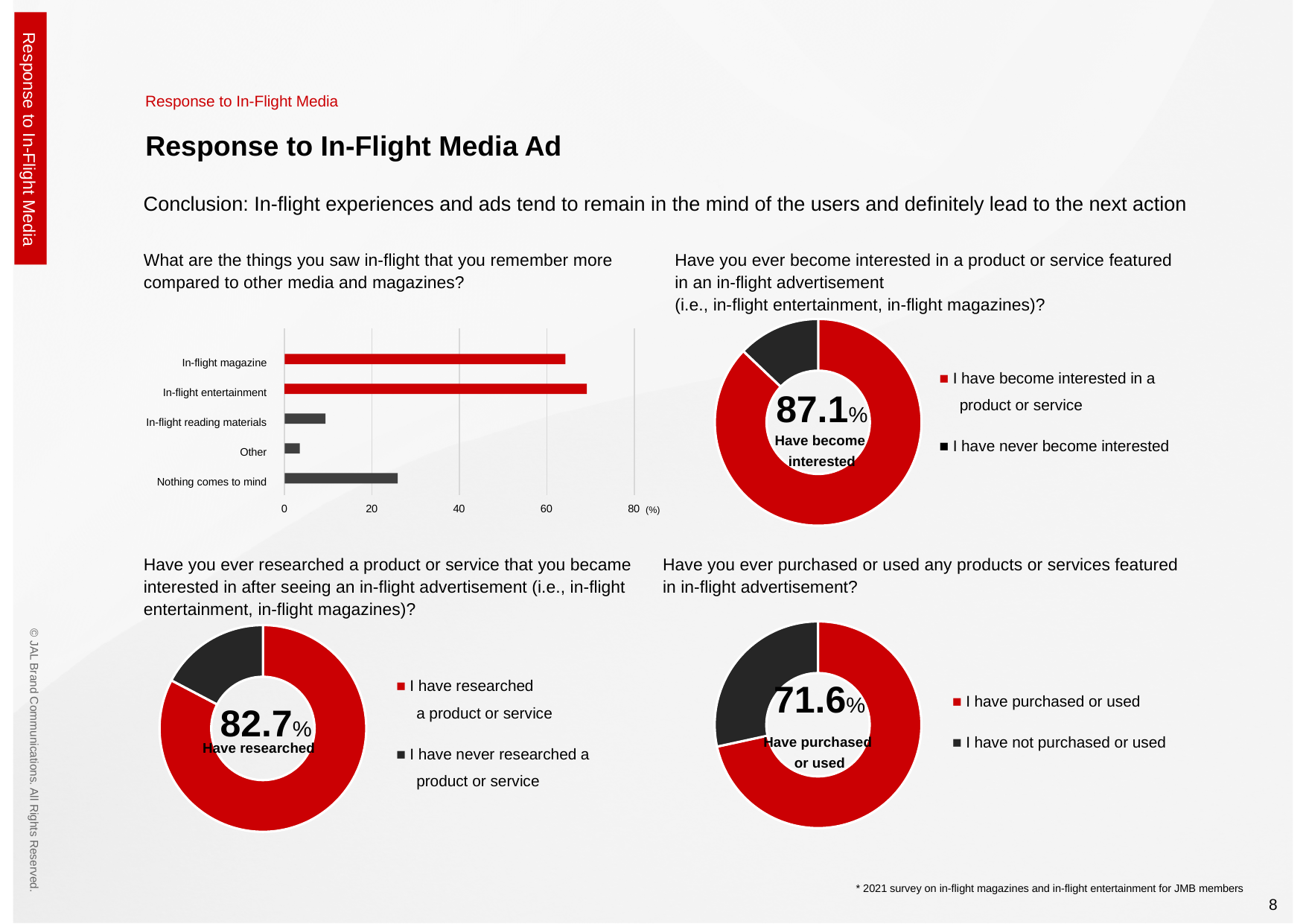
What type of chart is used for the question about things remembered in-flight compared to other media? Bar chart In the donut chart about becoming interested in a product or service featured in an in-flight advertisement, what percentage have become interested? 87.1% How many categories are shown in the bar chart about things remembered in-flight? 5 In the bar chart about things remembered in-flight, which category has the lowest value? Other In the bar chart about things remembered in-flight, is the value for In-flight reading materials greater or less than 20? less In the donut chart about purchasing or using products featured in in-flight advertisement, what percentage have purchased or used? 71.6% In the bar chart about things remembered in-flight, is the value for Nothing comes to mind greater or less than 40? less In the bar chart about things remembered in-flight, which category has the highest value? In-flight entertainment How many entries does the legend list in the donut chart about purchasing or using products featured in in-flight advertisement? 2 In the bar chart about things remembered in-flight, which is larger: In-flight magazine or Nothing comes to mind? In-flight magazine In the donut chart about researching a product or service after seeing an in-flight advertisement, what percentage have researched? 82.7% In the bar chart about things remembered in-flight, is the value for In-flight magazine greater or less than 60? greater